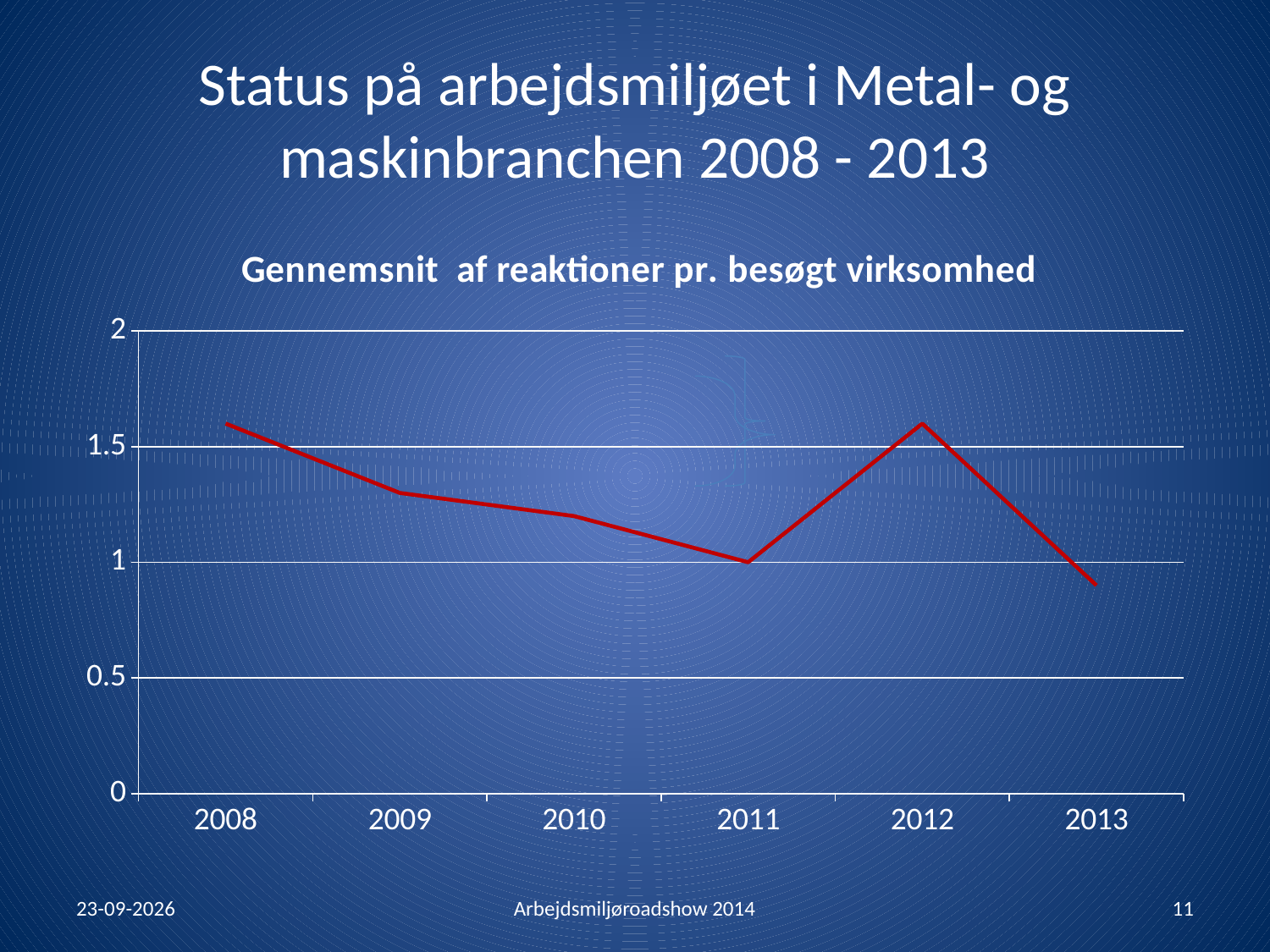
Is the value for 2012 greater or less than 1.5? greater Is the value for 2010 greater or less than 1? greater How many years are plotted on the x axis of the chart? 6 Do the values rise or fall from 2008 to 2011? fall Which year has the larger value, 2009 or 2012? 2012 Is the value for 2013 greater or less than 1? less What colour is the line in the chart? red Which year has the lowest value in the chart? 2013 What kind of chart is shown on the slide? line chart What is the title of the chart? Gennemsnit af reaktioner pr. besøgt virksomhed